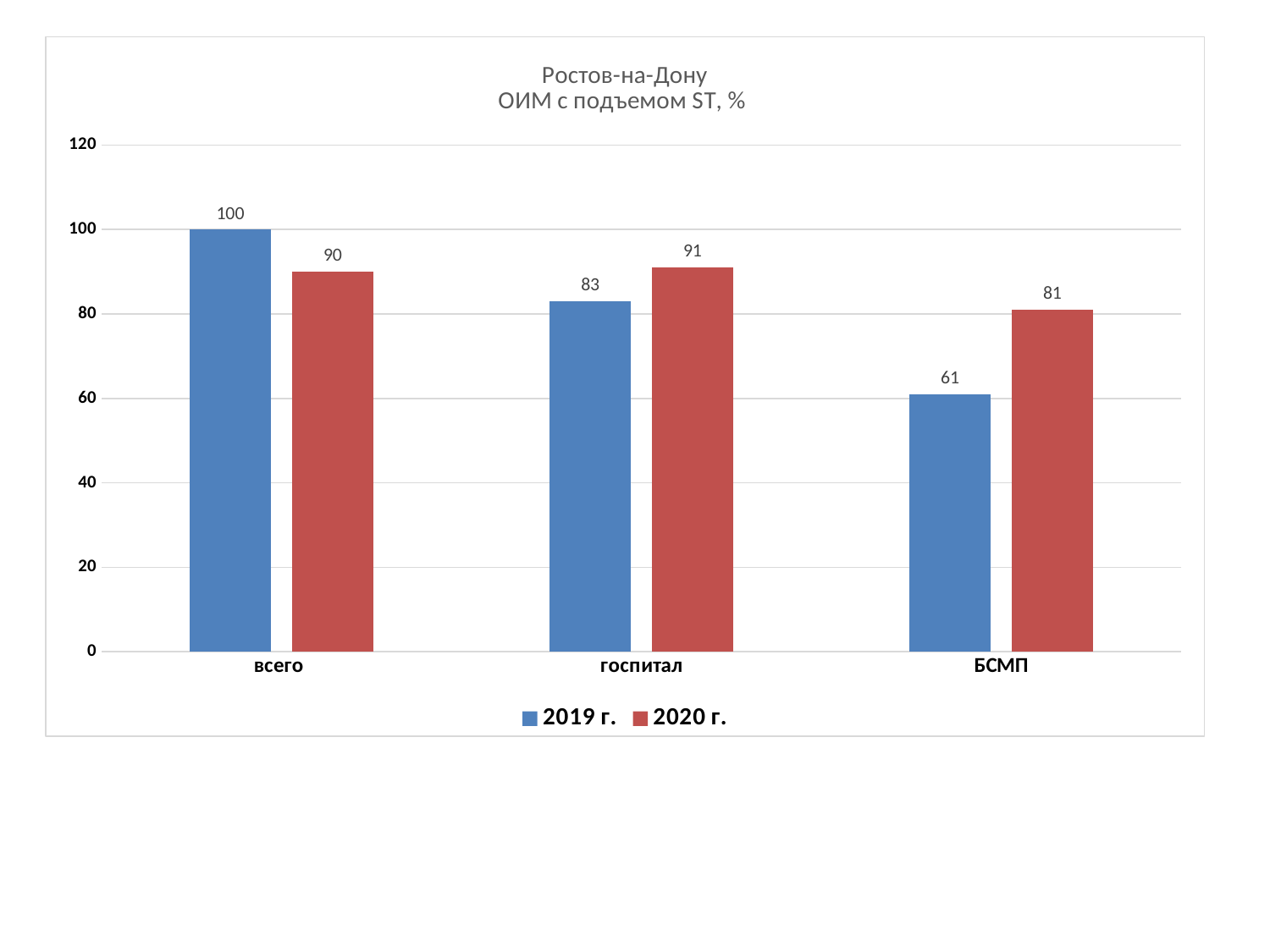
What is the value for 2019 г. in the всего category? 100 How many categories are shown on the x axis? 3 What is the value for 2020 г. in the БСМП category? 81 What is the value for 2020 г. in the госпиталь category? 91 What is the value for 2019 г. in the БСМП category? 61 What is the title of the chart? Ростов-на-Дону ОИМ с подъемом ST, % Which is larger in the госпиталь category, the 2019 г. value or the 2020 г. value? 2020 г. How many series does the legend list? 2 What kind of chart is shown on the slide? bar chart Which category has the highest value for 2019 г.? всего What is the difference between the 2020 г. and 2019 г. values in the БСМП category? 20 Which category has the lowest value for 2020 г.? БСМП